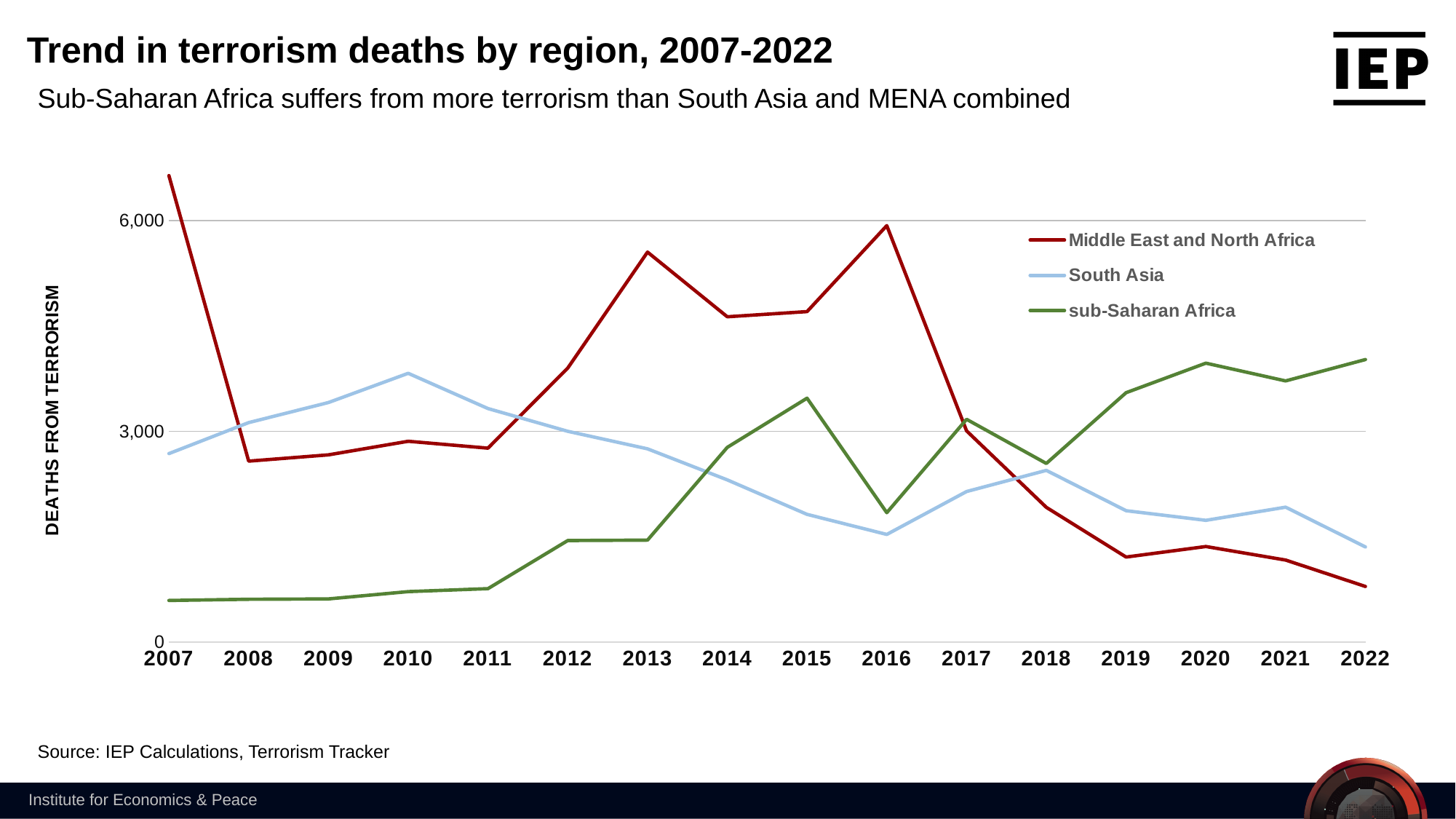
Which region has the lowest number of deaths from terrorism in 2007? sub-Saharan Africa Is the value for South Asia in 2010 greater or less than 3,000? greater How many years are plotted along the x axis? 16 How many series does the legend list? 3 What kind of chart is shown on the slide? line chart Is the value for sub-Saharan Africa in 2007 greater or less than 3,000? less In 2013, which is larger: deaths for Middle East and North Africa or for sub-Saharan Africa? Middle East and North Africa Is the value for Middle East and North Africa in 2007 greater or less than 6,000? greater Which region has the highest number of deaths from terrorism in 2022? sub-Saharan Africa Do deaths from terrorism for Middle East and North Africa rise or fall from 2016 to 2022? fall What is the title of the chart? Trend in terrorism deaths by region, 2007-2022